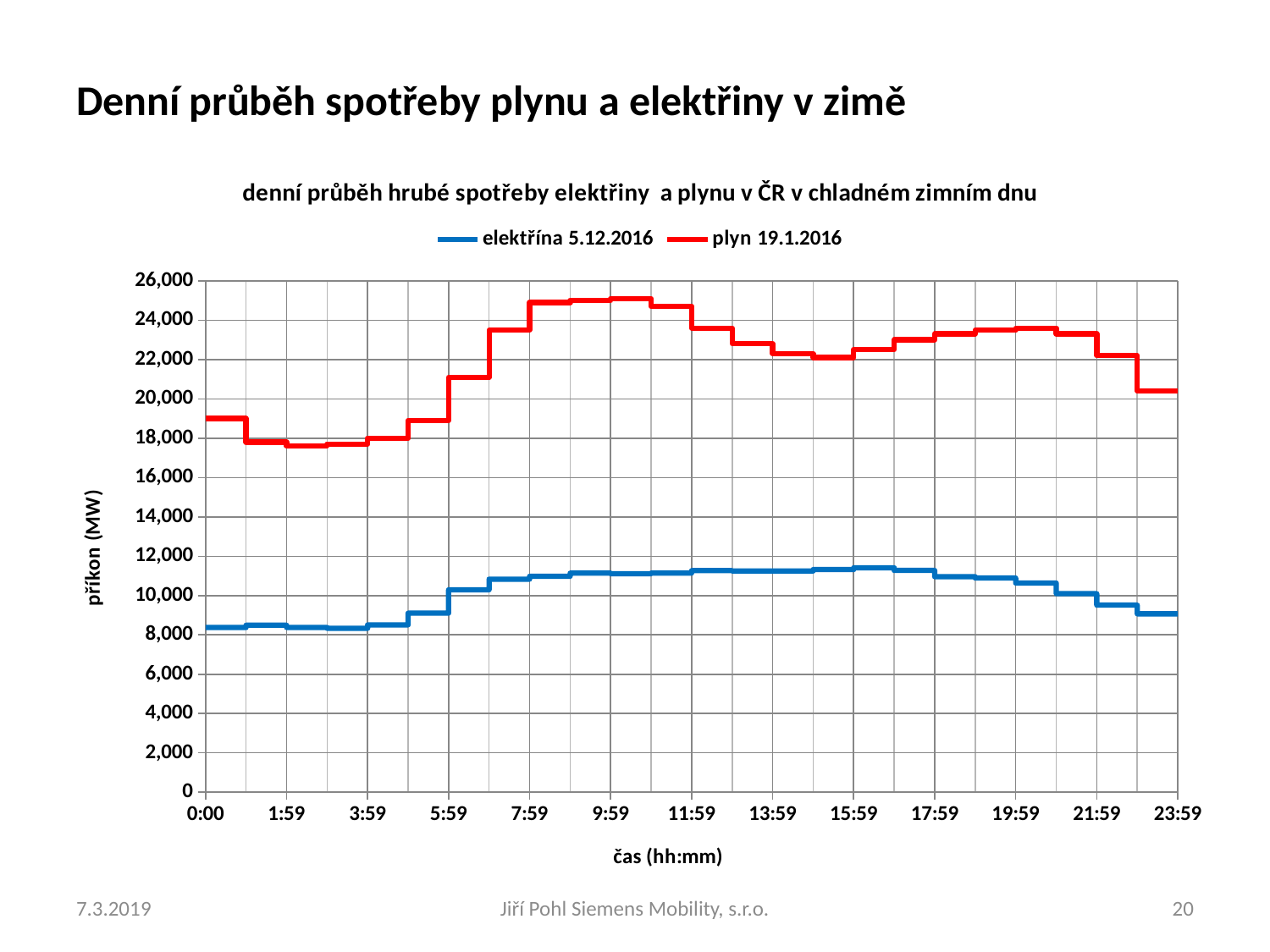
Which series has the higher value at 11:59, elektřína 5.12.2016 or plyn 19.1.2016? plyn 19.1.2016 Which series is drawn in red? plyn 19.1.2016 Is the value for plyn 19.1.2016 at 9:59 greater or less than 24,000? greater Is the value for plyn 19.1.2016 at 0:00 greater or less than 18,000? greater Is the value for plyn 19.1.2016 at 2:59 greater or less than 20,000? less What is the label of the y axis? příkon (MW) Does the plyn 19.1.2016 series rise or fall between 9:59 and 15:59? fall How many series does the legend list? 2 Does the elektřína 5.12.2016 series rise or fall between 0:00 and 7:59? rise What kind of chart is shown on the slide? line chart